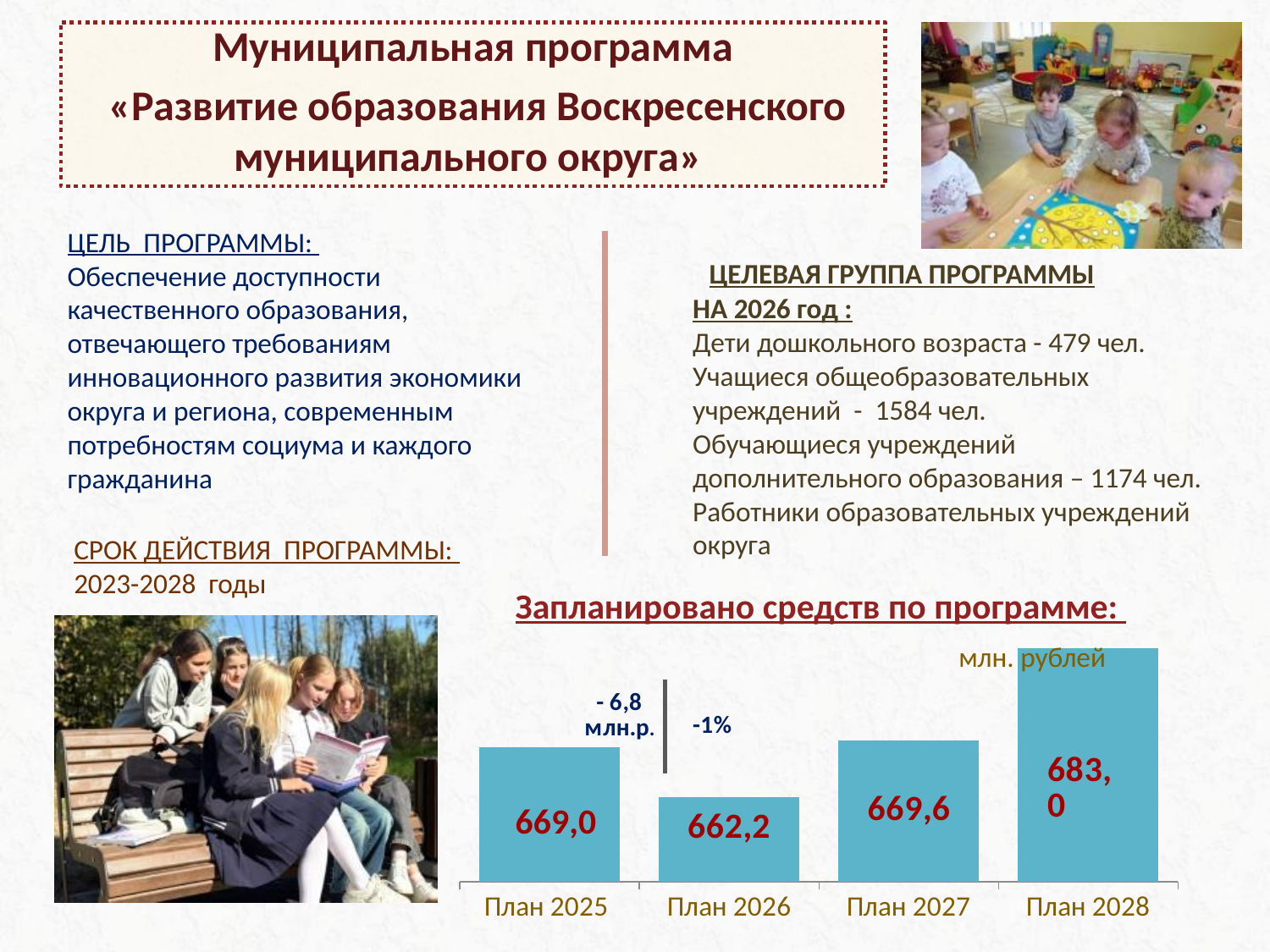
What is the difference between the planned amounts for План 2028 and План 2026? 20,8 What change is annotated between План 2025 and План 2026 in the chart? - 6,8 млн.р. (-1%) What is the planned amount for План 2026? 662,2 What is the planned amount for План 2028? 683,0 What is the planned amount for План 2027? 669,6 What is the planned amount for План 2025? 669,0 Which year has the lowest planned amount? План 2026 What type of chart is shown under the heading «Запланировано средств по программе»? bar chart Which year has the highest planned amount? План 2028 Which is larger, the planned amount for План 2025 or План 2026? План 2025 In what units are the values in the chart expressed? млн. рублей How many years (categories) are shown in the chart? 4